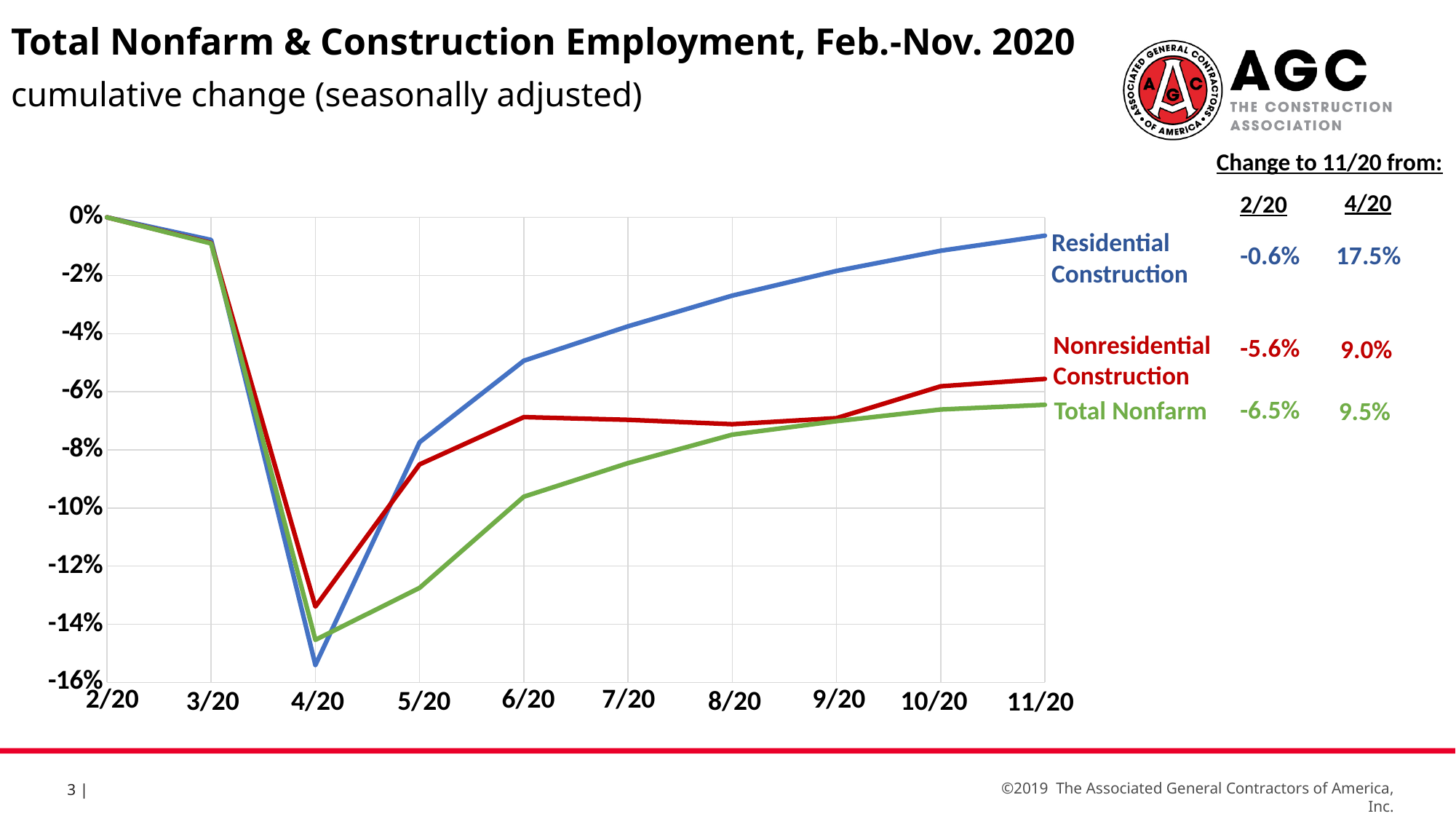
Is the value for Total Nonfarm at 6/20 greater or less than -8%? less At 11/20, which is higher: Nonresidential Construction or Total Nonfarm? Nonresidential Construction What is the difference between the Residential Construction and Total Nonfarm values at 11/20? 5.9% Which series has the lowest value at 4/20? Residential Construction What is the change to 11/20 from 4/20 for Residential Construction? 17.5% Is the value for Nonresidential Construction at 4/20 greater or less than -12%? less How many series does the chart plot? 3 What is the cumulative change for Residential Construction at 11/20? -0.6% Does the Residential Construction line rise or fall from 4/20 to 11/20? rise How many months are shown along the x axis of the chart? 10 What kind of chart is shown on the slide? line chart What is the cumulative change for Total Nonfarm at 11/20? -6.5%